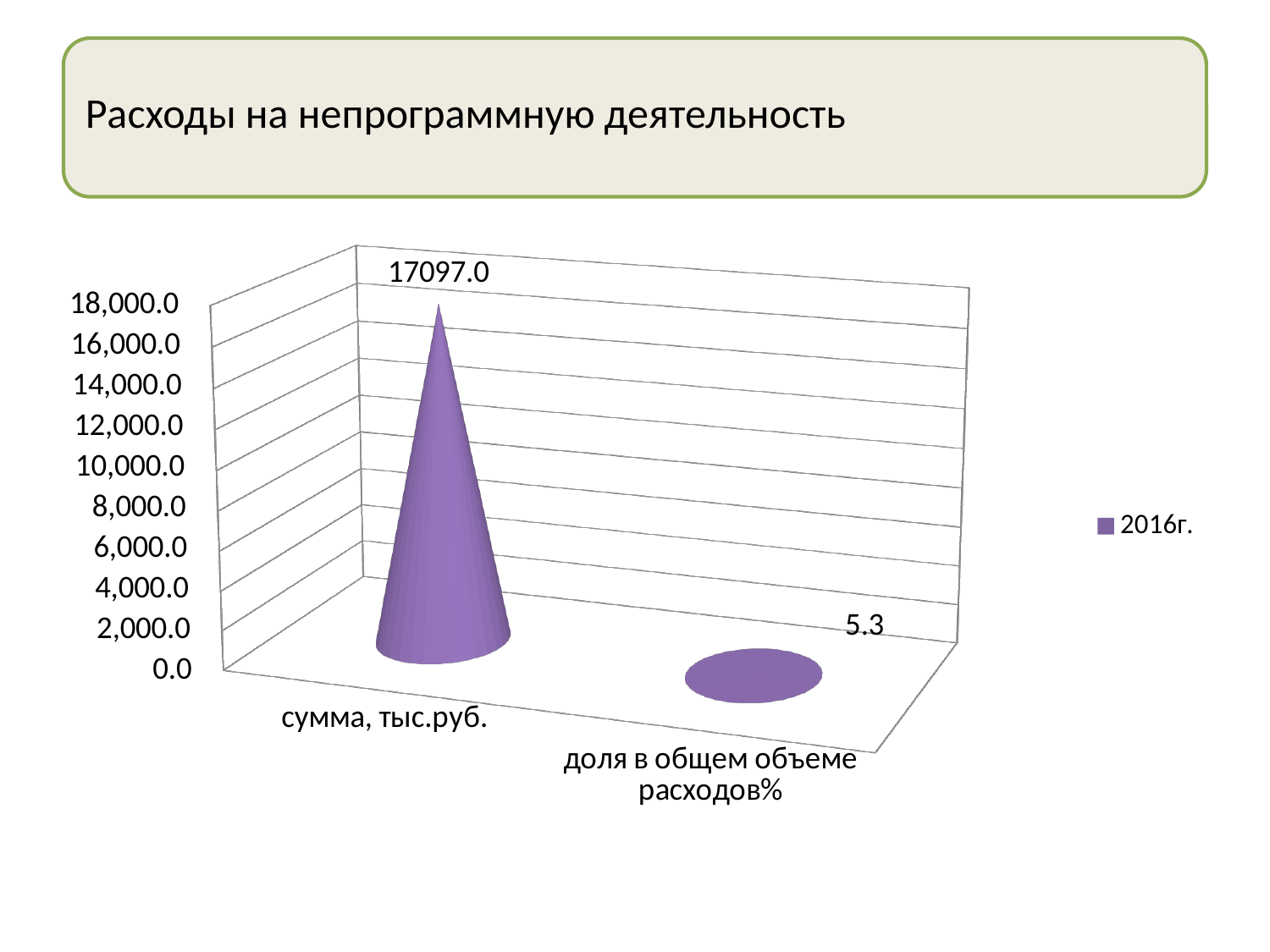
What is the value for "сумма, тыс.руб."? 17097.0 Is the value for "сумма, тыс.руб." greater or less than 16,000.0? greater What is the difference between the value for "сумма, тыс.руб." and the value for "доля в общем объеме расходов%"? 17091.7 What is the value for "доля в общем объеме расходов%"? 5.3 Which category has the highest value? сумма, тыс.руб. How many series does the legend list? 1 What kind of chart is shown on the slide? bar chart Which category has the lowest value? доля в общем объеме расходов% Is the value for "доля в общем объеме расходов%" greater or less than 2,000.0? less Which is larger: the value for "сумма, тыс.руб." or the value for "доля в общем объеме расходов%"? сумма, тыс.руб. What series name is shown in the legend? 2016г. How many categories are shown on the x axis? 2